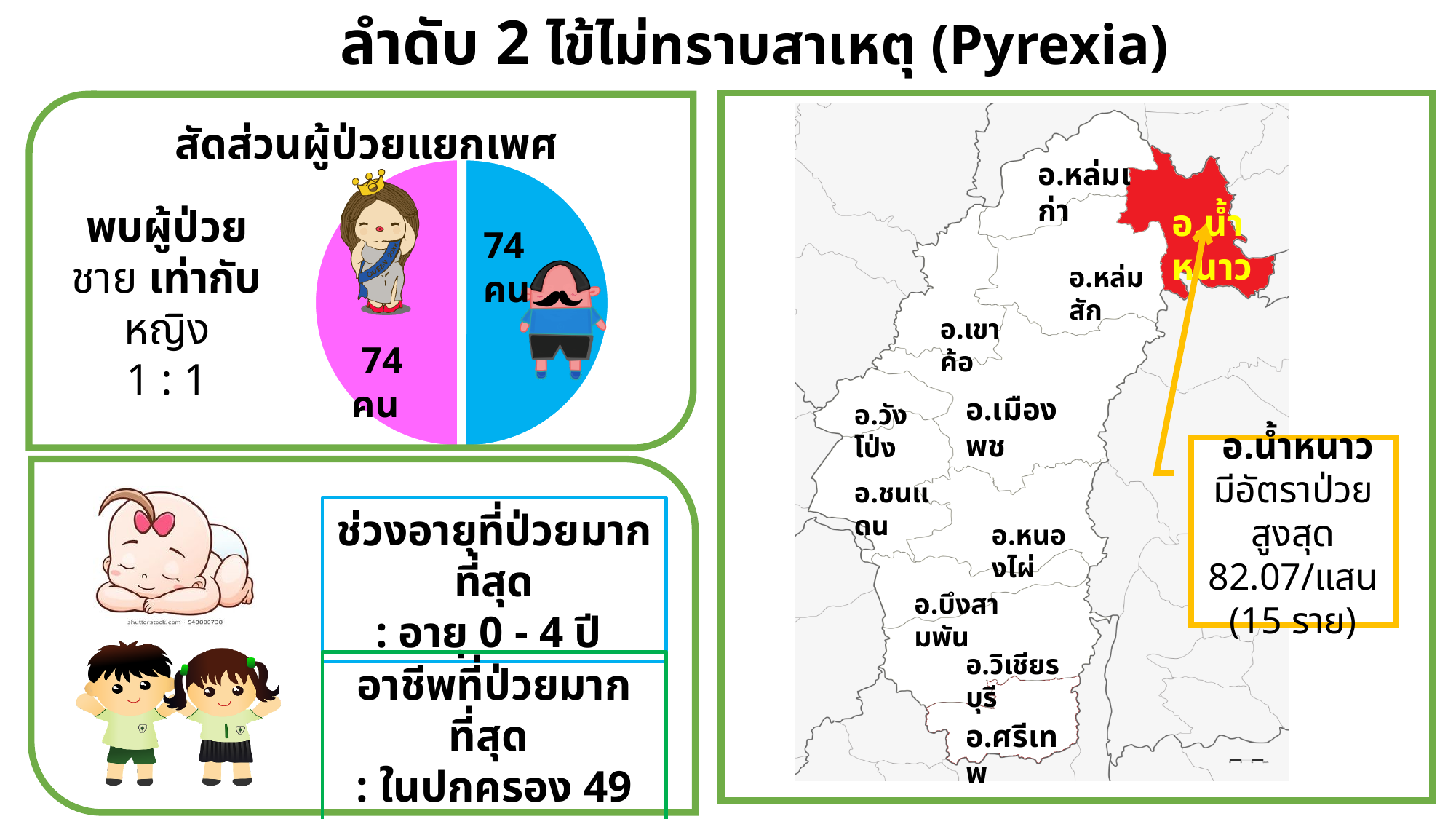
What share of the pie chart does the male (blue) slice represent? 50% What is the total number of patients represented by the two slices of the pie chart? 148 คน In the pie chart, what is the value shown on the pink (female) slice? 74 คน What kind of chart is shown in the top-left box of the slide? Pie chart How many slices does the pie chart have? 2 What is the title of the pie chart? สัดส่วนผู้ป่วยแยกเพศ According to the text next to the pie chart, what is the ratio of male to female patients? 1 : 1 Which colour is used for the female slice in the pie chart? Pink What share of the pie chart does the female (pink) slice represent? 50% In the pie chart, what is the value shown on the blue (male) slice? 74 คน What is the difference between the male and female values in the pie chart? 0